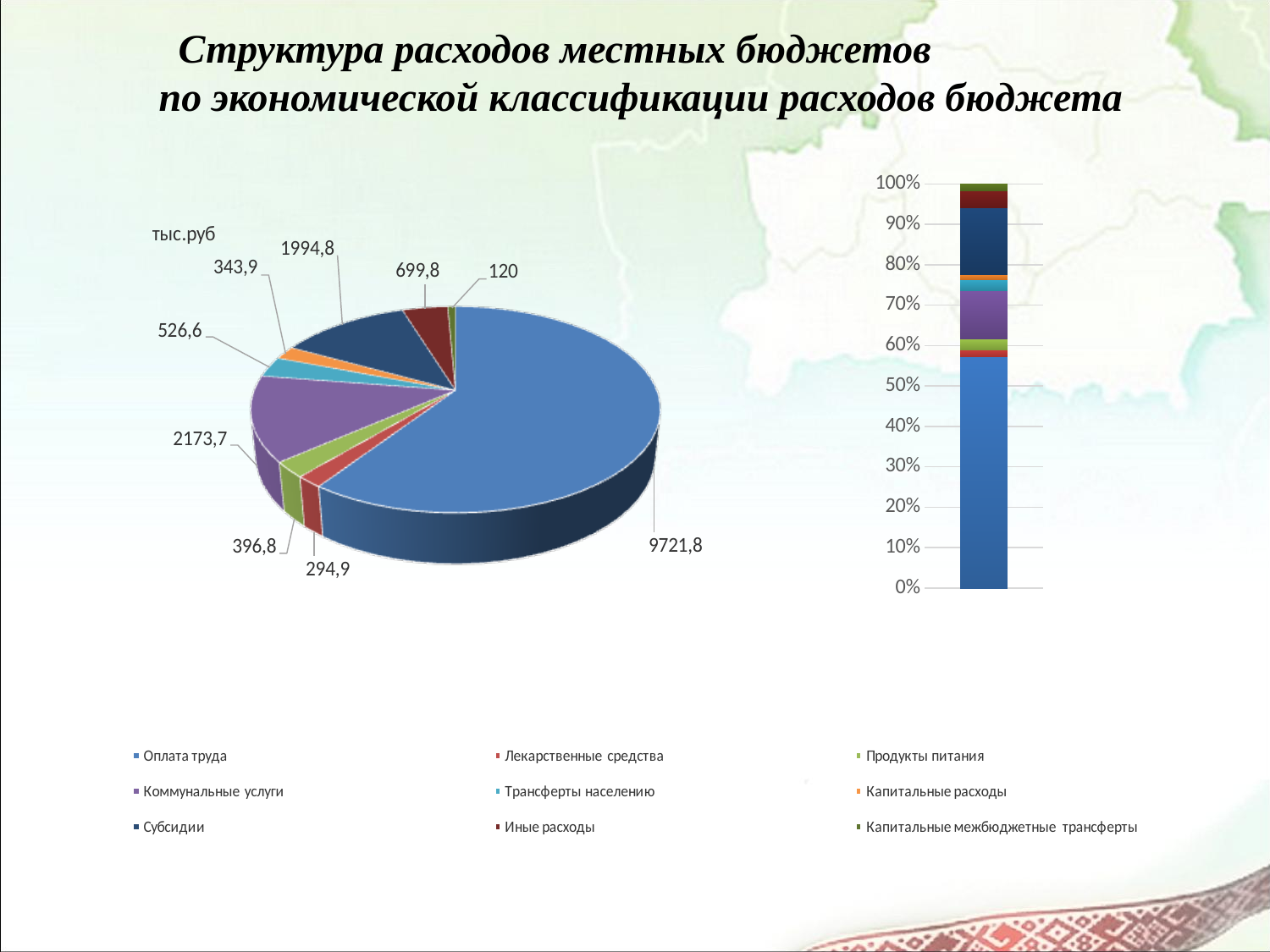
In the pie chart, which is larger: Трансферты населению or Капитальные расходы? Трансферты населению In the pie chart, what is the value for Субсидии? 1994,8 In the pie chart, which category has the largest value? Оплата труда What kind of chart is shown on the left side of the slide? Pie chart How many categories does the legend list? 9 In the pie chart, what is the value for Иные расходы? 699,8 In the stacked bar chart on the right, is the share for Оплата труда greater or less than 50%? greater In the pie chart, what is the difference between the values for Коммунальные услуги and Субсидии? 178,9 In the pie chart, which category has the smallest value? Капитальные межбюджетные трансферты In the pie chart, what is the value for Оплата труда? 9721,8 What unit is shown above the pie chart? тыс.руб In the pie chart, what is the value for Коммунальные услуги? 2173,7